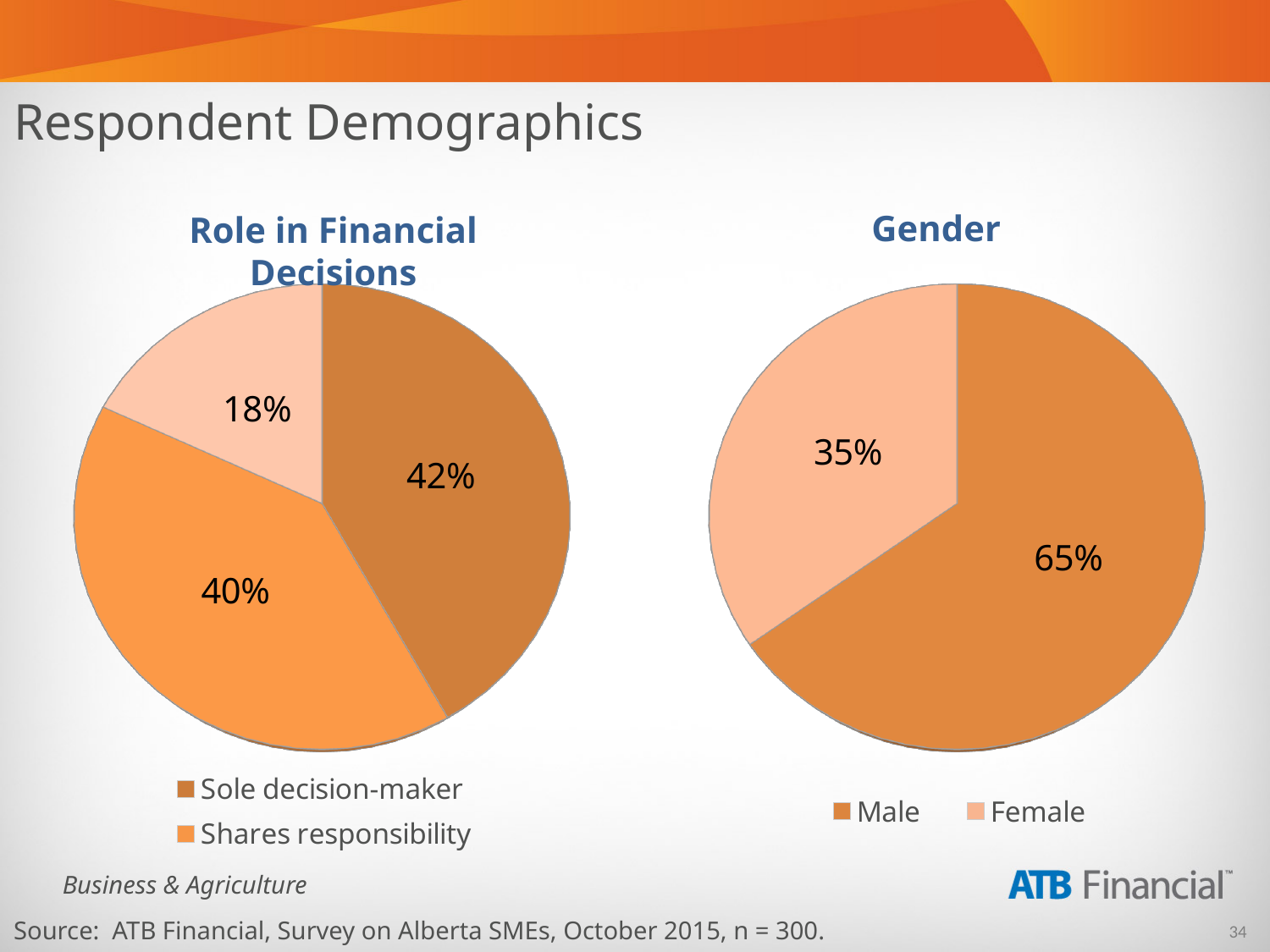
In the 'Gender' chart, what share of respondents are Female? 35% In the 'Gender' chart, what share of respondents are Male? 65% In the 'Role in Financial Decisions' chart, which is larger: 'Sole decision-maker' or 'Shares responsibility'? Sole decision-maker In the 'Role in Financial Decisions' chart, what share of respondents are sole decision-makers? 42% In the 'Role in Financial Decisions' chart, what is the value of the smallest slice? 18% In the 'Gender' chart, which category has the larger share? Male How many slices does the 'Role in Financial Decisions' pie chart have? 3 In the 'Role in Financial Decisions' chart, what share of respondents share responsibility? 40% What is the title of the pie chart on the right side of the slide? Gender In the 'Gender' chart, what is the difference in percentage points between Male and Female? 30 How many entries does the legend of the 'Gender' chart list? 2 What kind of chart is the 'Gender' chart? pie chart